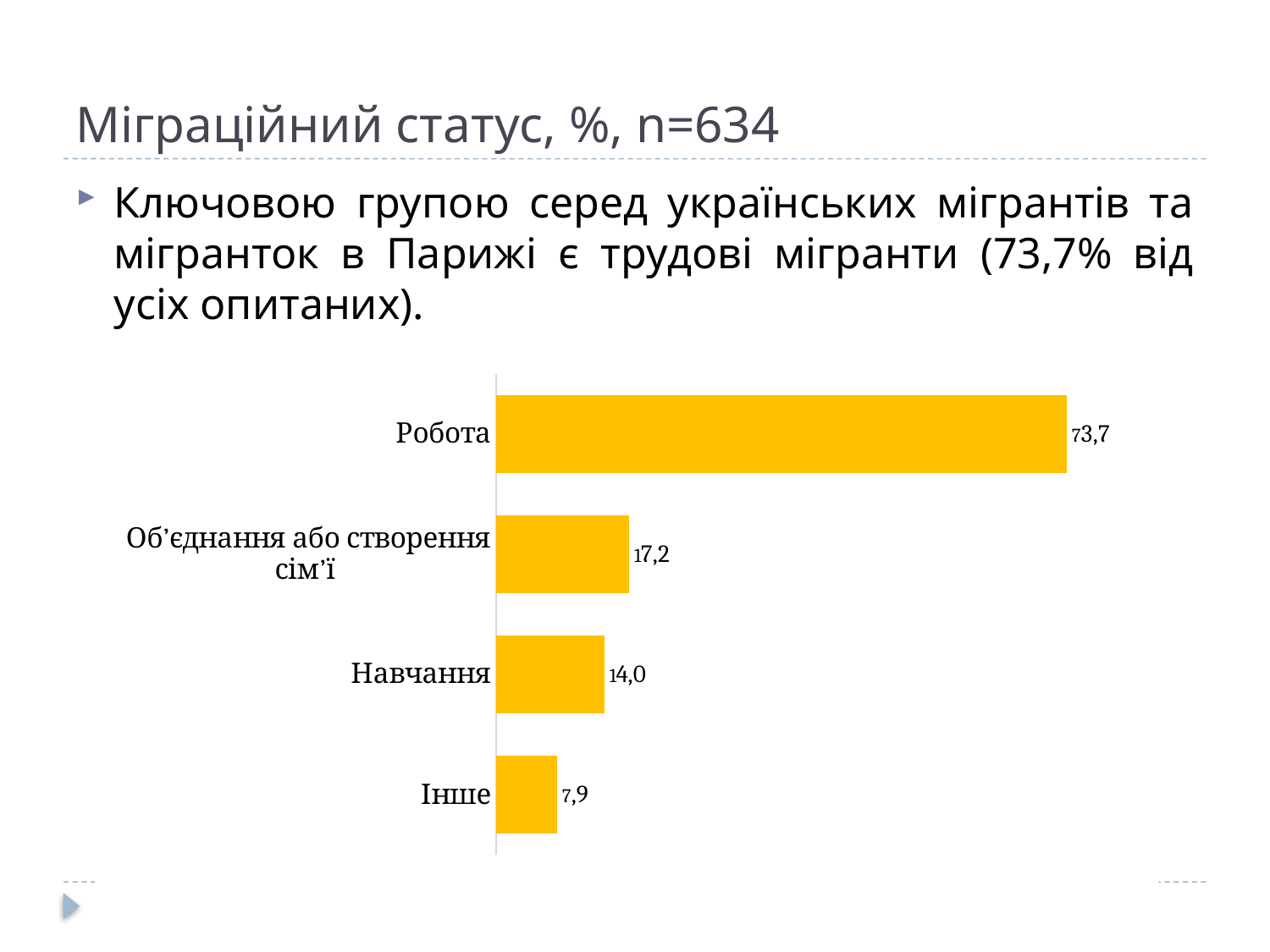
What is the value for Навчання? 14,0 What is the value for Робота? 73,7 What is the value for Об'єднання або створення сім'ї? 17,2 Which category has the highest value? Робота Which is larger, the value for Об'єднання або створення сім'ї or the value for Навчання? Об'єднання або створення сім'ї What kind of chart is shown on the slide? bar chart How many categories are shown in the chart? 4 What colour are the bars in the chart? yellow What is the difference between the values for Навчання and Інше? 6,1 What is the difference between the values for Робота and Об'єднання або створення сім'ї? 56,5 Which category has the lowest value? Інше What is the value for Інше? 7,9